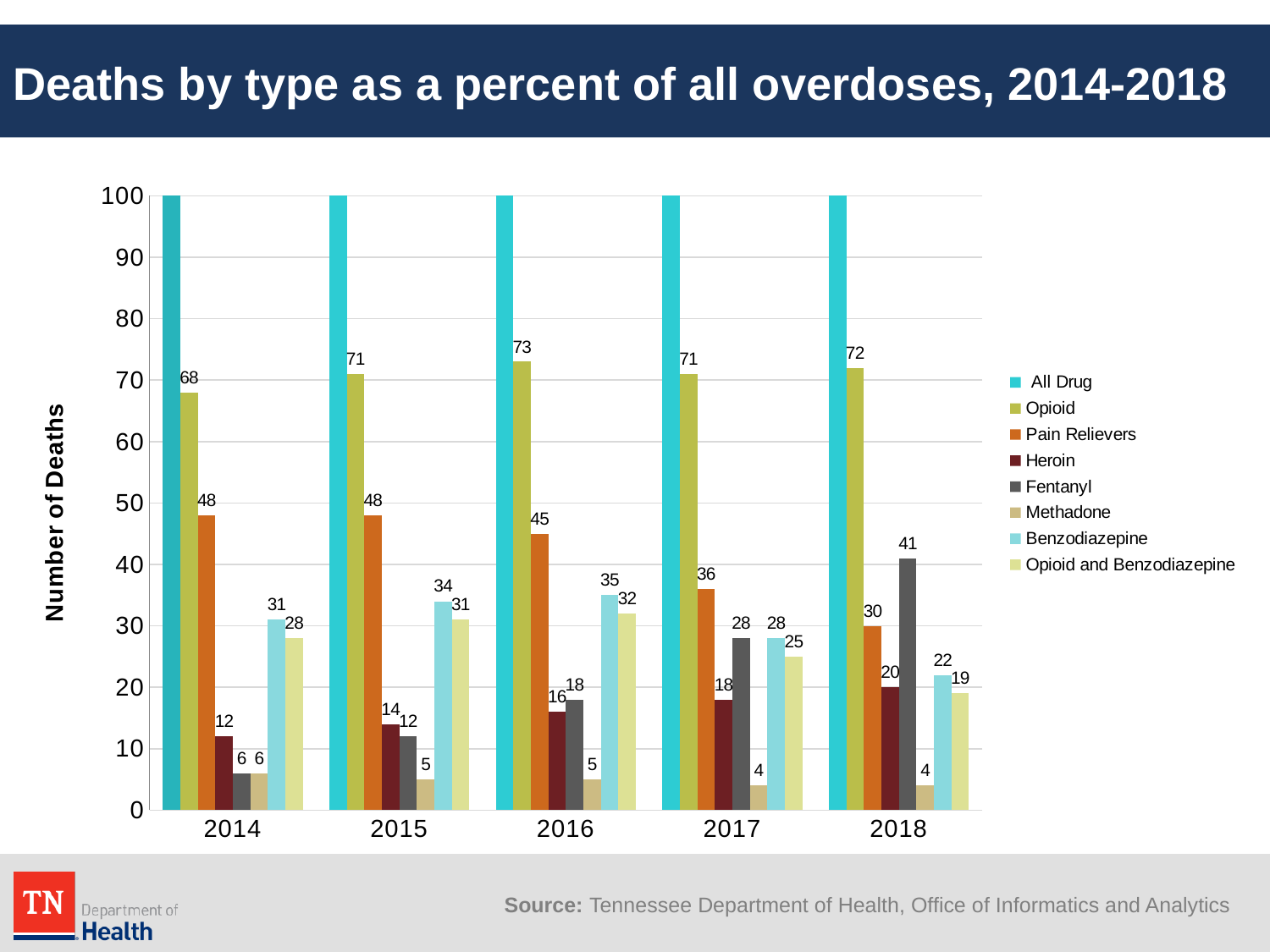
In which year is the Fentanyl value highest? 2018 Which is larger in 2017, the Heroin value or the Fentanyl value? Fentanyl What is the difference between the Pain Relievers values in 2014 and 2018? 18 How many years are shown on the x axis? 5 What is the value for Fentanyl in 2018? 41 What is the value for Opioid in 2016? 73 What is the title of the chart? Deaths by type as a percent of all overdoses, 2014-2018 What type of chart is shown on the slide? Bar chart What is the value for Pain Relievers in 2014? 48 How many series does the legend list? 8 In which year is the Pain Relievers value lowest? 2018 Do the Heroin values rise or fall from 2014 to 2018? Rise